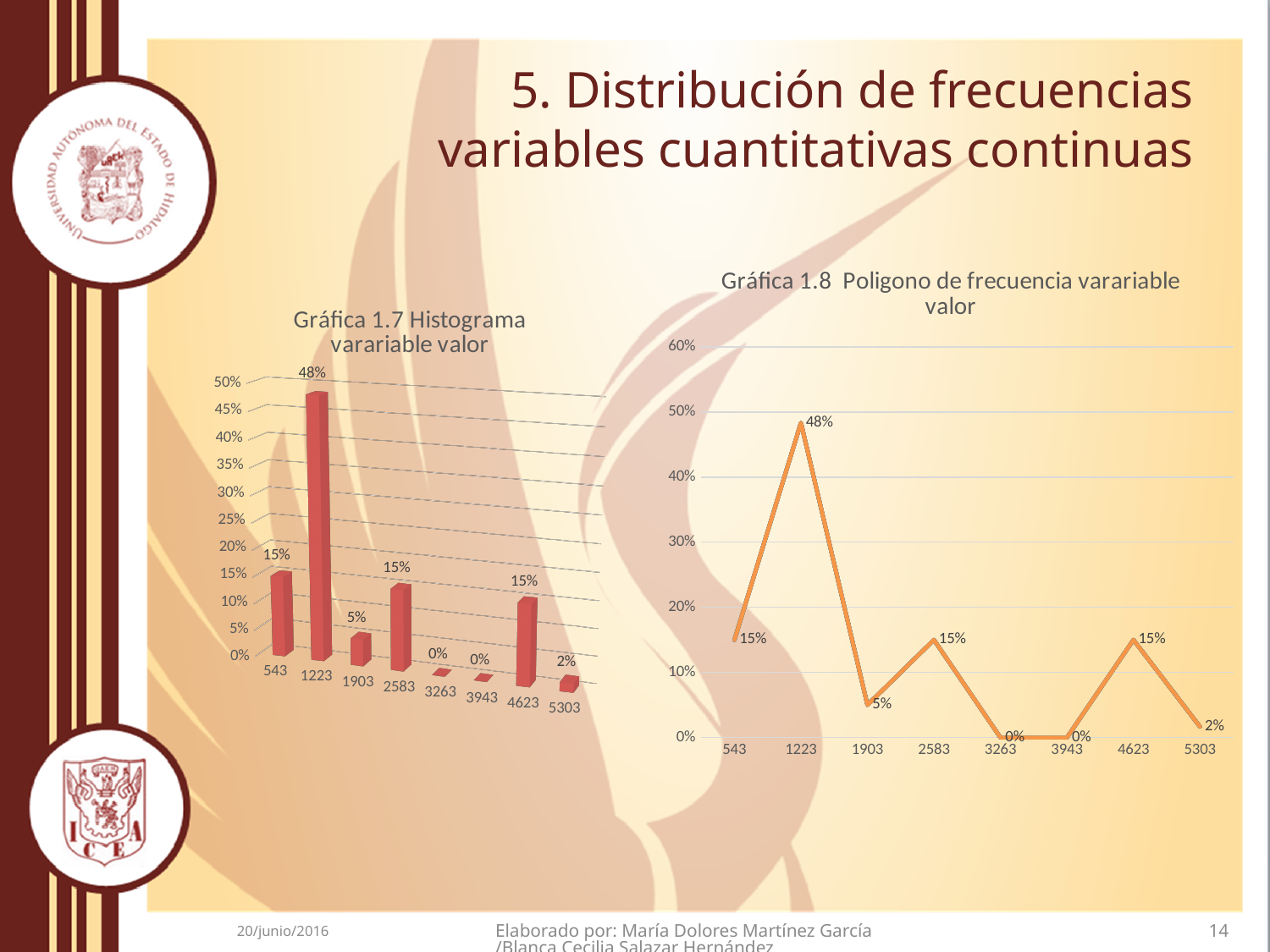
What kind of chart is 'Gráfica 1.7 Histograma varariable valor'? bar chart What is the title of the chart on the right side of the slide? Gráfica 1.8 Poligono de frecuencia varariable valor In the chart titled 'Gráfica 1.7 Histograma varariable valor', which is larger, the value for 1903 or the value for 5303? 1903 In the chart titled 'Gráfica 1.7 Histograma varariable valor', what is the value for the category 1223? 48% In the chart titled 'Gráfica 1.7 Histograma varariable valor', how many categories are shown on the x axis? 8 In the chart titled 'Gráfica 1.7 Histograma varariable valor', what is the value for the category 1903? 5% In the chart titled 'Gráfica 1.8 Poligono de frecuencia varariable valor', how many categories have a value of 0%? 2 In the chart titled 'Gráfica 1.8 Poligono de frecuencia varariable valor', does the value rise or fall from 1223 to 1903? fall In the chart titled 'Gráfica 1.8 Poligono de frecuencia varariable valor', what is the difference between the values for 1223 and 543? 33% In the chart titled 'Gráfica 1.8 Poligono de frecuencia varariable valor', which category has the highest value? 1223 In the chart titled 'Gráfica 1.8 Poligono de frecuencia varariable valor', what is the value for the category 5303? 2% What kind of chart is 'Gráfica 1.8 Poligono de frecuencia varariable valor'? line chart